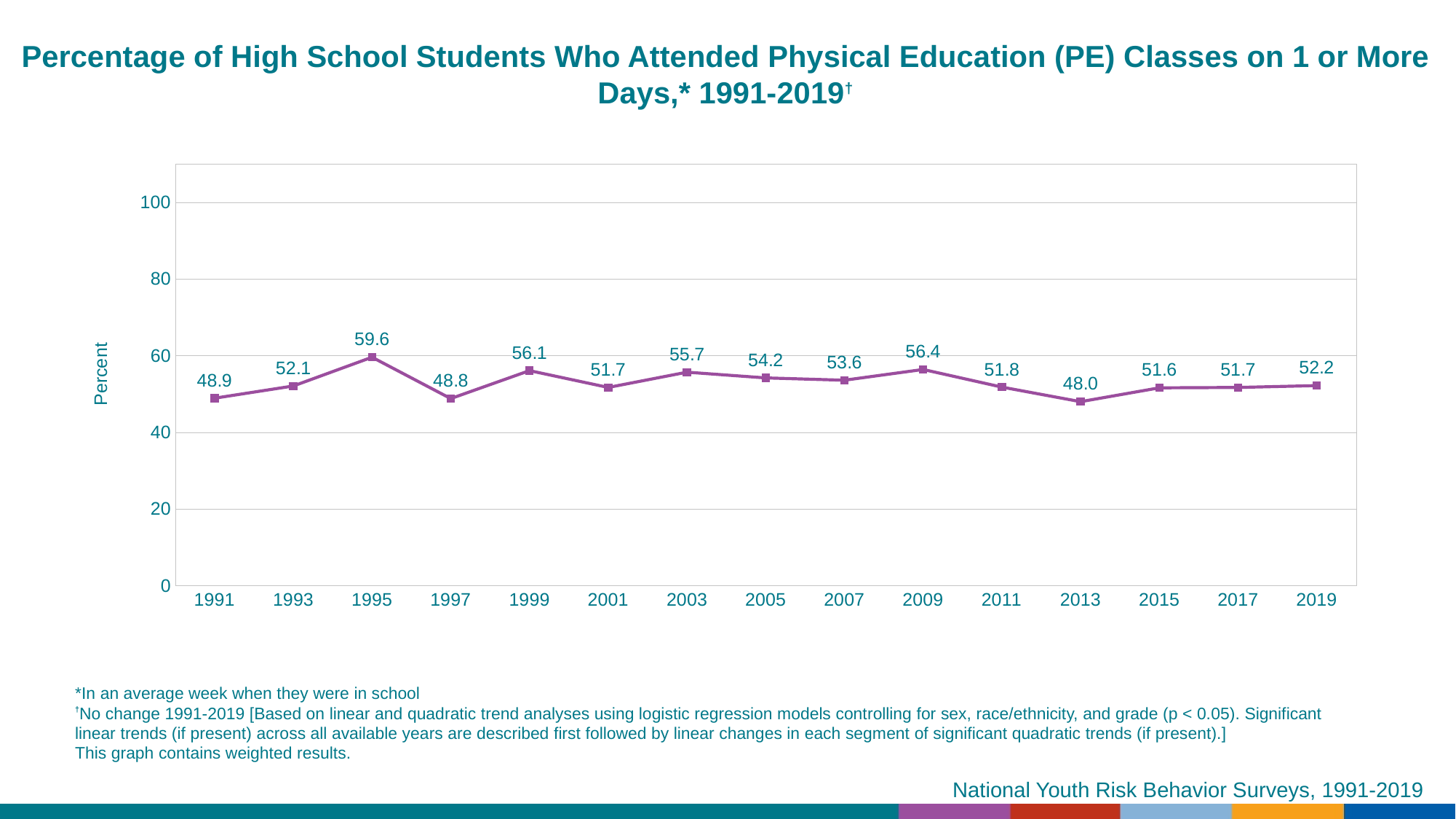
What kind of chart is shown on the slide? line chart What percentage of high school students attended PE classes on 1 or more days in 1995? 59.6 What is the label on the y axis? Percent What is the value plotted for 2013? 48.0 How many years are plotted on the x axis? 15 What is the difference between the values for 1995 and 2013? 11.6 Which year has the highest percentage? 1995 What is the value plotted for 2019? 52.2 Which year has a larger value, 1999 or 2003? 1999 What is the difference between the values for 2009 and 2011? 4.6 Which year has the lowest percentage? 2013 Is the value for 1997 greater or less than 60? less